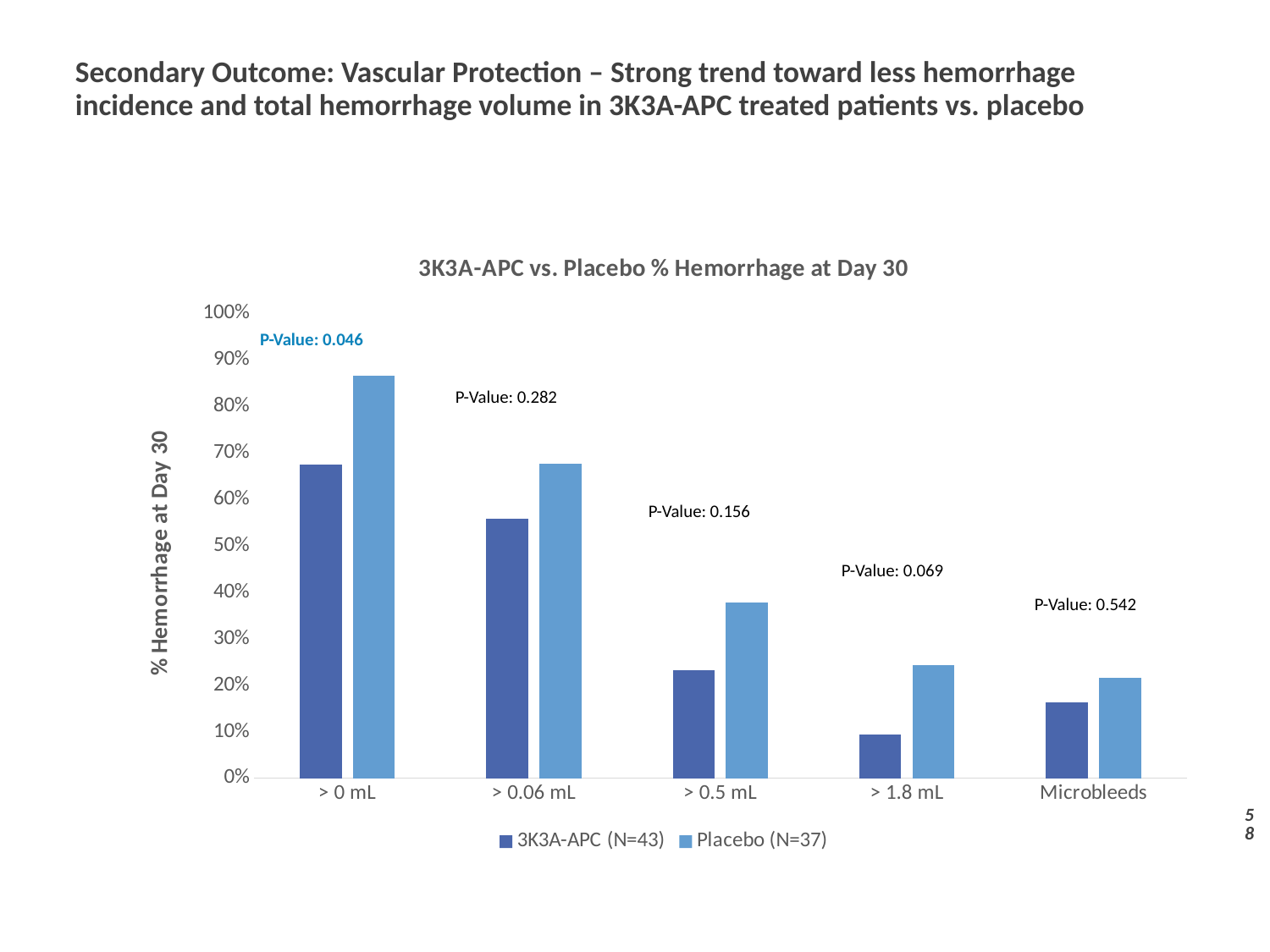
Is the Placebo (N=37) value for > 0 mL greater or less than 80%? greater How many series does the legend list? 2 How many categories are shown on the x axis? 5 Is the 3K3A-APC (N=43) value for > 0.06 mL greater or less than 50%? greater For the > 0 mL category, which series has the larger value, 3K3A-APC (N=43) or Placebo (N=37)? Placebo (N=37) Which category has the lowest 3K3A-APC (N=43) bar? > 1.8 mL Do the Placebo (N=37) values rise or fall from > 0 mL to Microbleeds along the x axis? fall Which category has the highest Placebo (N=37) bar? > 0 mL What P-value is printed above the > 0 mL category? P-Value: 0.046 What kind of chart is shown on the slide? bar chart Is the 3K3A-APC (N=43) value for > 1.8 mL greater or less than 20%? less